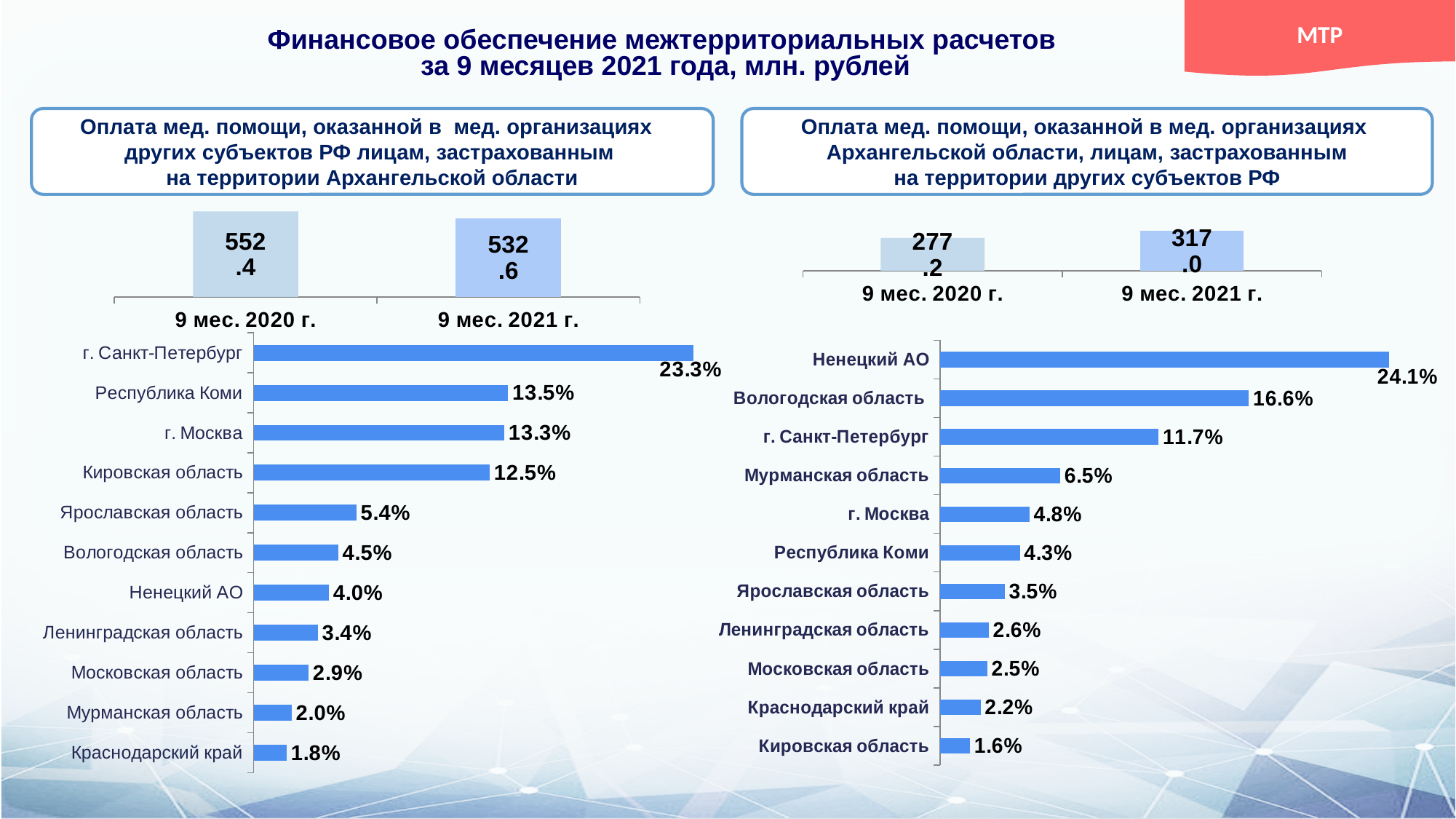
In the bottom-right horizontal bar chart, what is the value for Ненецкий АО? 24.1% In the top-right bar chart (payment for care in Arkhangelsk region organisations to persons insured in other regions), what is the value for 9 мес. 2021 г.? 317.0 In the bottom-left horizontal bar chart, what is the value for Кировская область? 12.5% In the top-right bar chart, what is the difference between the 9 мес. 2021 г. and 9 мес. 2020 г. values? 39.8 In the top-left bar chart (payment for care in other regions' organisations to persons insured in Arkhangelsk region), what is the value for 9 мес. 2020 г.? 552.4 In the top-left bar chart, did the value rise or fall from 9 мес. 2020 г. to 9 мес. 2021 г.? fall In the top-left bar chart, what is the value for 9 мес. 2021 г.? 532.6 In the bottom-right horizontal bar chart, which is larger: Мурманская область or г. Москва? Мурманская область What type of chart is the bottom-left chart? bar chart In the bottom-left horizontal bar chart, which region has the lowest share? Краснодарский край In the bottom-left horizontal bar chart, which region has the highest share? г. Санкт-Петербург How many regions are shown in the bottom-right horizontal bar chart? 11